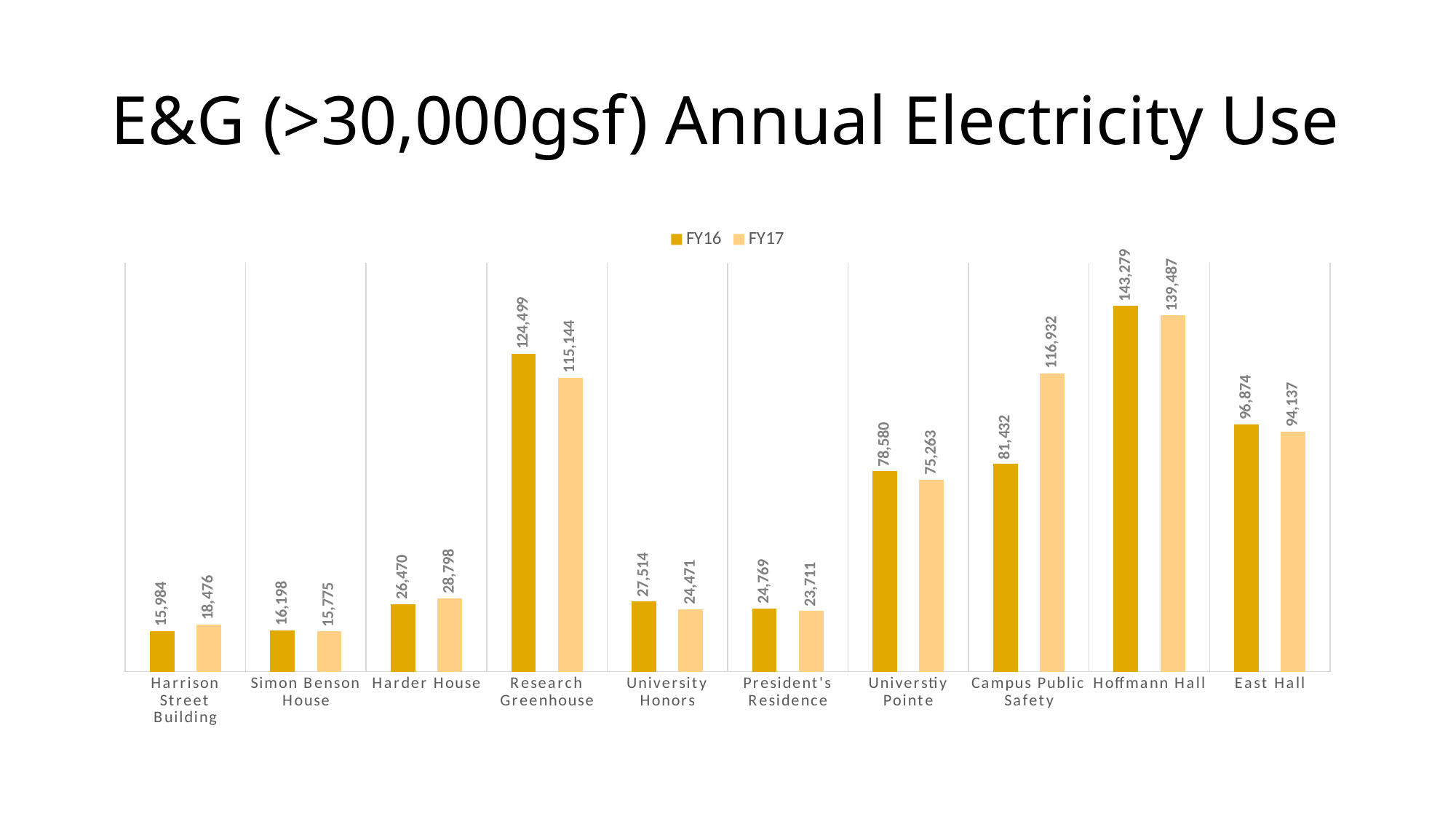
Which building has the lowest FY17 value? Simon Benson House What kind of chart is shown on the slide? Bar chart What is the difference between the FY16 and FY17 values for Hoffmann Hall? 3,792 What is the difference between the FY17 and FY16 values for Campus Public Safety? 35,500 What is the FY17 value for Harder House? 28,798 Which is larger for East Hall, the FY16 value or the FY17 value? FY16 Which building has the highest FY16 value? Hoffmann Hall What is the FY16 value for Research Greenhouse? 124,499 How many series does the legend list? 2 How many buildings are shown on the x axis? 10 Which is larger for Harrison Street Building, the FY16 value or the FY17 value? FY17 What is the FY17 value for Campus Public Safety? 116,932